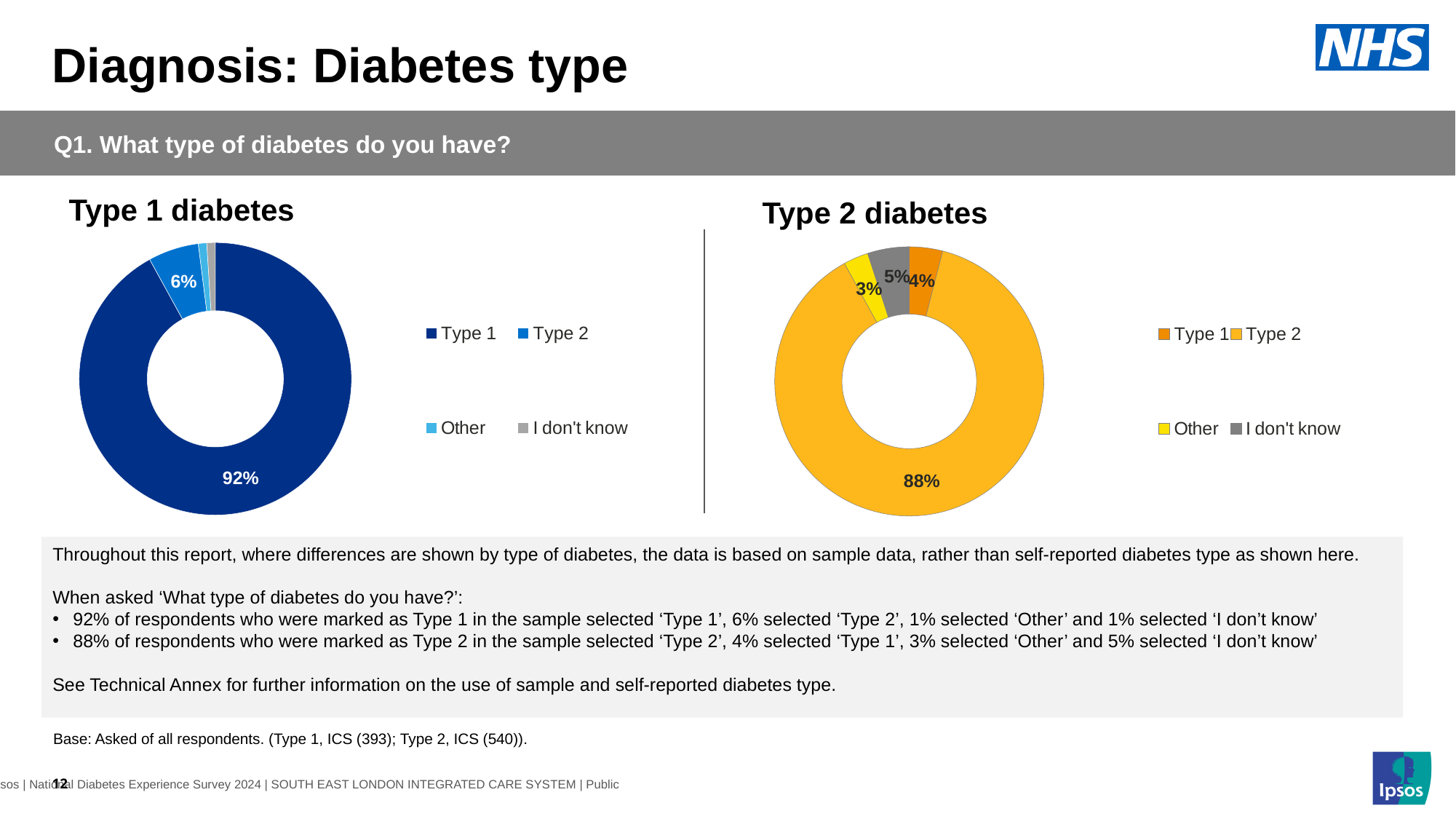
In the 'Type 1 diabetes' chart, what percentage of respondents selected 'Type 2'? 6% In the 'Type 2 diabetes' chart, what percentage of respondents selected 'I don't know'? 5% In the 'Type 2 diabetes' chart, what percentage of respondents selected 'Type 2'? 88% In the 'Type 1 diabetes' chart, what percentage of respondents selected 'Type 1'? 92% In the 'Type 2 diabetes' chart, which category has the largest share? Type 2 In the 'Type 2 diabetes' chart, what is the difference between the 'Type 2' share and the 'I don't know' share? 83% In the 'Type 2 diabetes' chart, what percentage of respondents selected 'Other'? 3% In the 'Type 2 diabetes' chart, what percentage of respondents selected 'Type 1'? 4% In the 'Type 2 diabetes' chart, which is larger: the share for 'I don't know' or the share for 'Other'? I don't know What kind of chart is used for 'Type 1 diabetes'? Donut (pie) chart How many categories does the legend of the 'Type 1 diabetes' chart list? 4 In the 'Type 1 diabetes' chart, which category has the largest share? Type 1